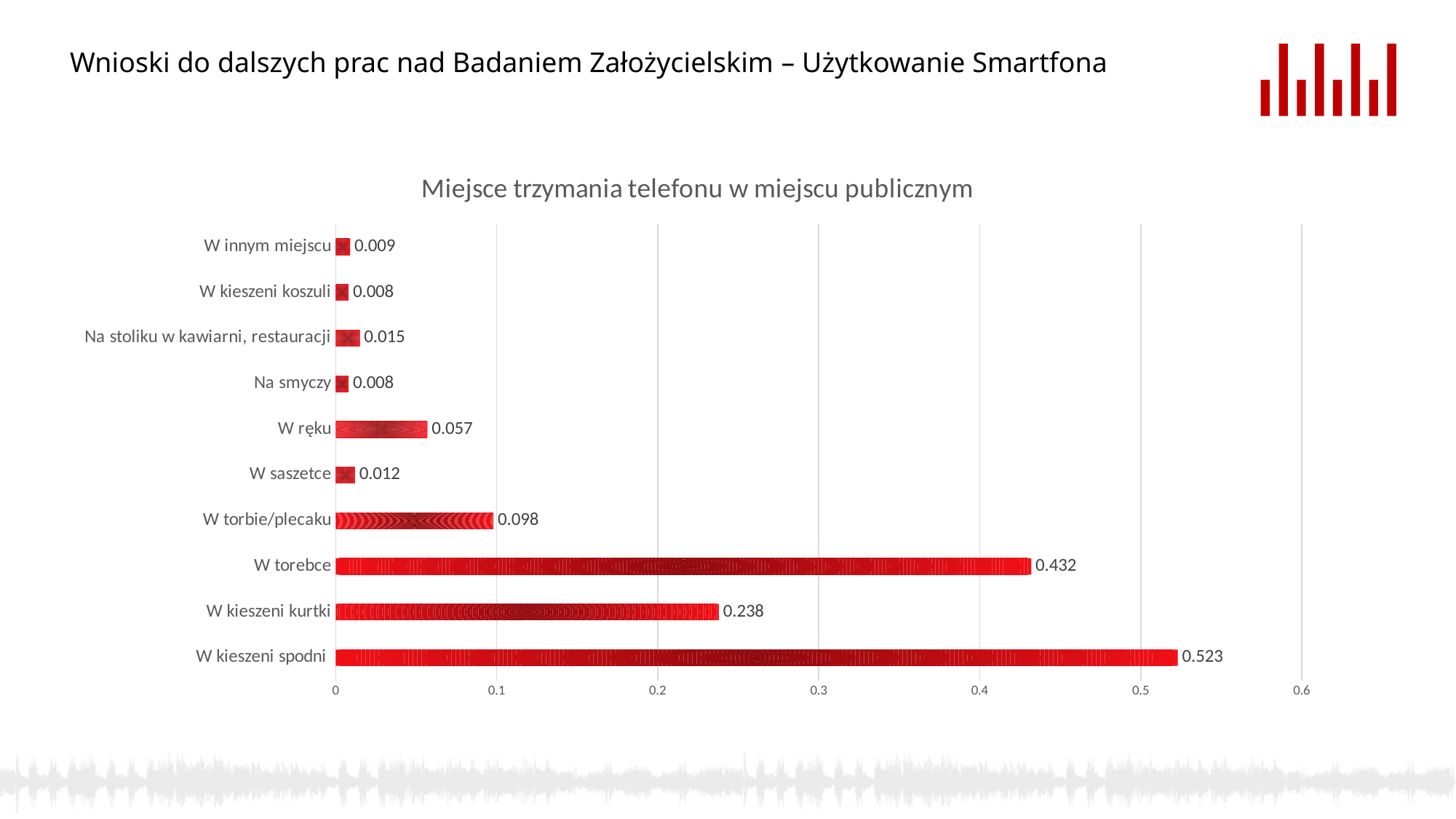
What is the value for W torbie/plecaku? 0.098 What is the difference between the values for W torebce and W kieszeni kurtki? 0.194 What is the value for Na stoliku w kawiarni, restauracji? 0.015 What kind of chart is shown on the slide? bar chart What is the title of the chart? Miejsce trzymania telefonu w miejscu publicznym What is the difference between the values for W kieszeni spodni and W torebce? 0.091 What is the value for W torebce? 0.432 What is the value for W kieszeni spodni? 0.523 Is the value for W kieszeni kurtki greater or less than 0.3? less Which is larger, the value for W ręku or the value for W torbie/plecaku? W torbie/plecaku How many categories are shown in the chart? 10 Which category has the highest value? W kieszeni spodni